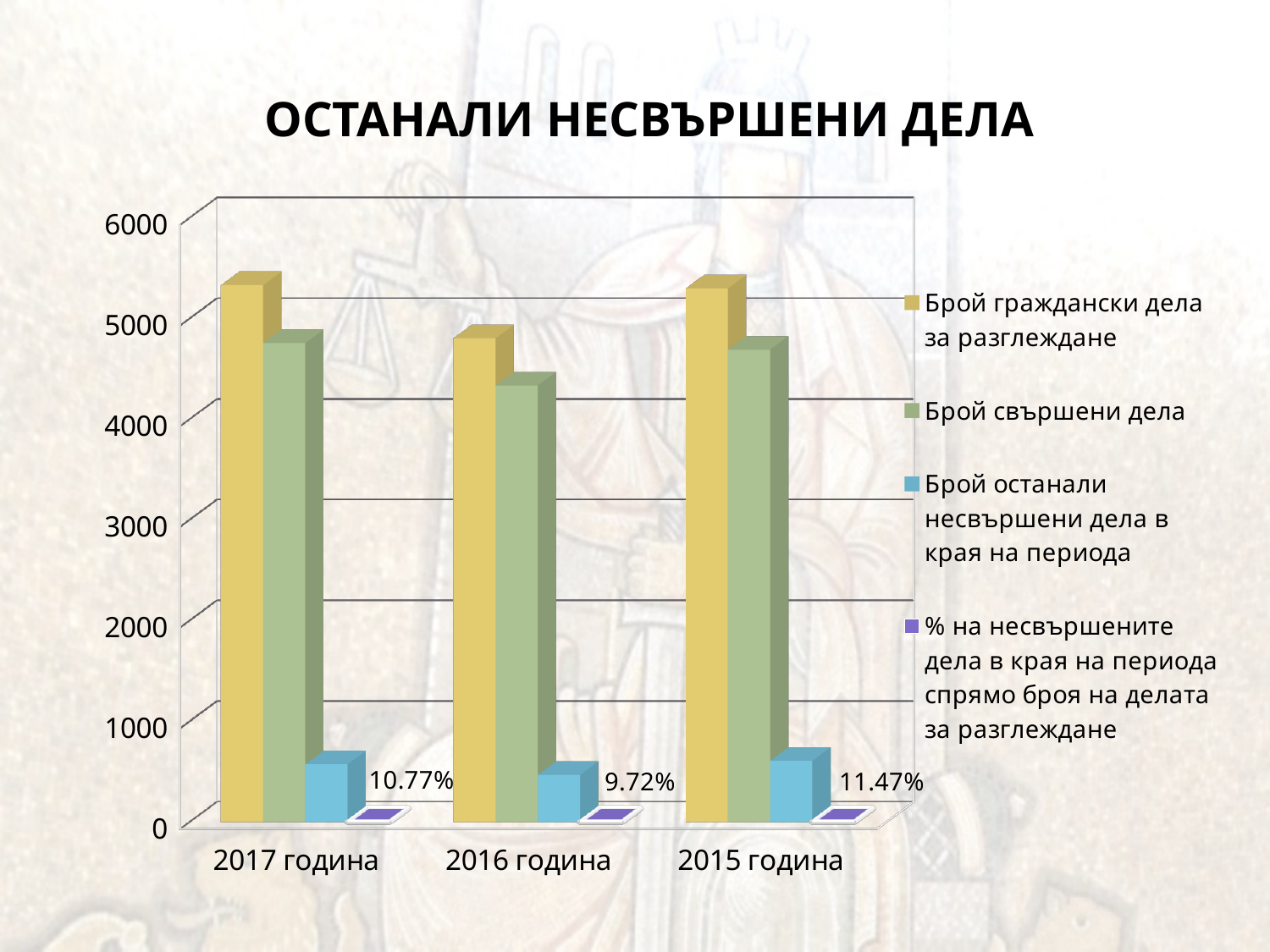
Which year has the lowest percentage of unfinished cases at the end of the period? 2016 година Is the value for "Брой останали несвършени дела в края на периода" in 2017 година greater or less than 1000? less How many series does the chart's legend list? 4 What is the difference between the percentage of unfinished cases for 2015 година and 2016 година? 1.75% What is the value of "% на несвършените дела в края на периода спрямо броя на делата за разглеждане" for 2017 година? 10.77% Is the value for "Брой свършени дела" in 2016 година greater or less than 4000? greater What is the value of "% на несвършените дела в края на периода спрямо броя на делата за разглеждане" for 2016 година? 9.72% Which year has the highest percentage of unfinished cases at the end of the period? 2015 година Which year has a larger value for "Брой граждански дела за разглеждане": 2017 година or 2016 година? 2017 година What is the value of "% на несвършените дела в края на периода спрямо броя на делата за разглеждане" for 2015 година? 11.47% How many years (categories) are shown on the x axis of the chart? 3 What type of chart is shown on the slide? Bar chart